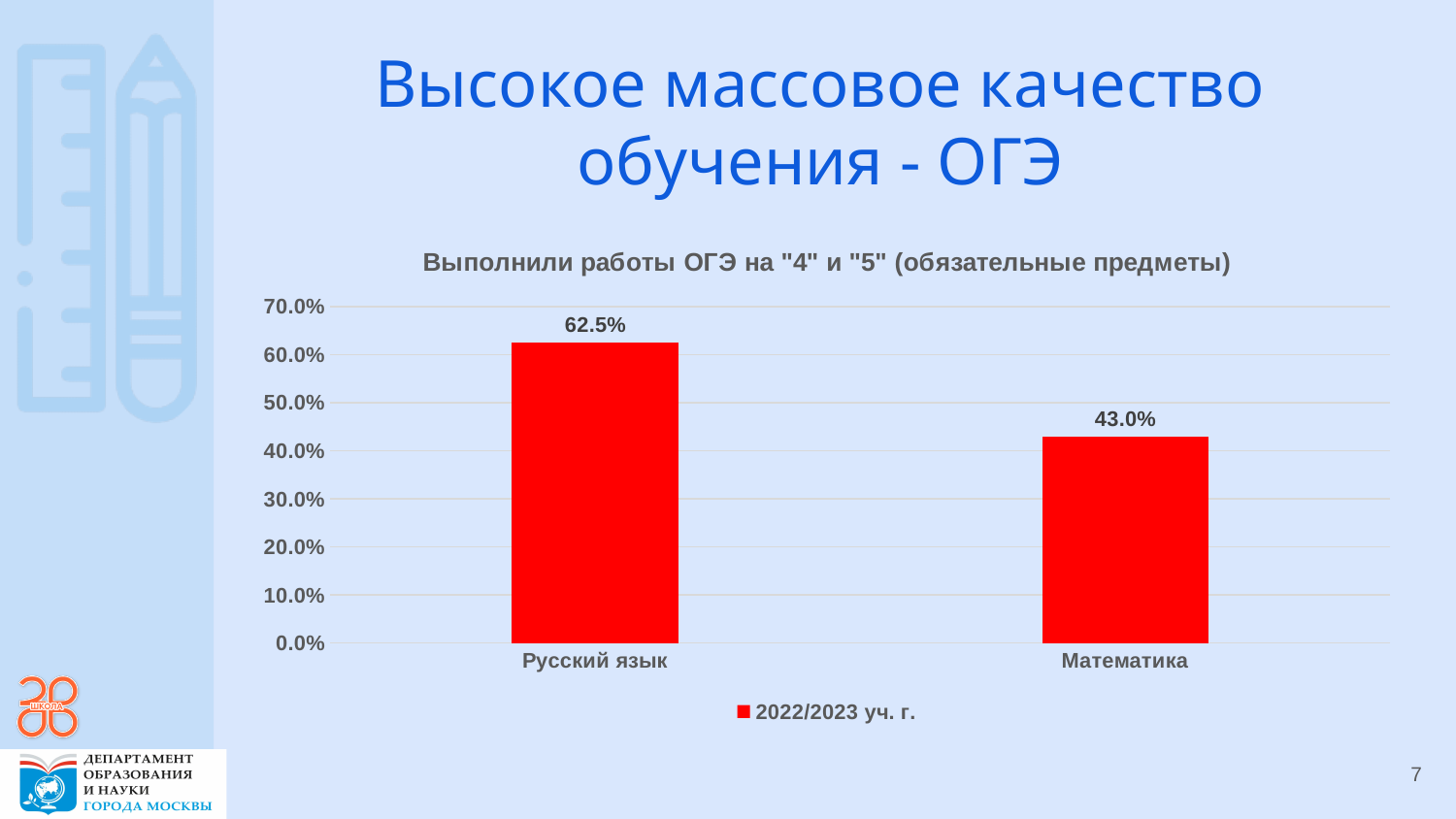
How many series does the legend list? 1 Which category has the highest value? Русский язык Which category has the lowest value? Математика What is the difference between the values for Русский язык and Математика? 19.5% What kind of chart is shown on the slide? bar chart What is the value for Математика? 43.0% How many categories are shown on the chart? 2 Which is larger, the value for Русский язык or the value for Математика? Русский язык What is the value for Русский язык? 62.5% What series name is shown in the chart legend? 2022/2023 уч. г. Is the value for Русский язык greater or less than 60.0%? greater Is the value for Математика greater or less than 50.0%? less